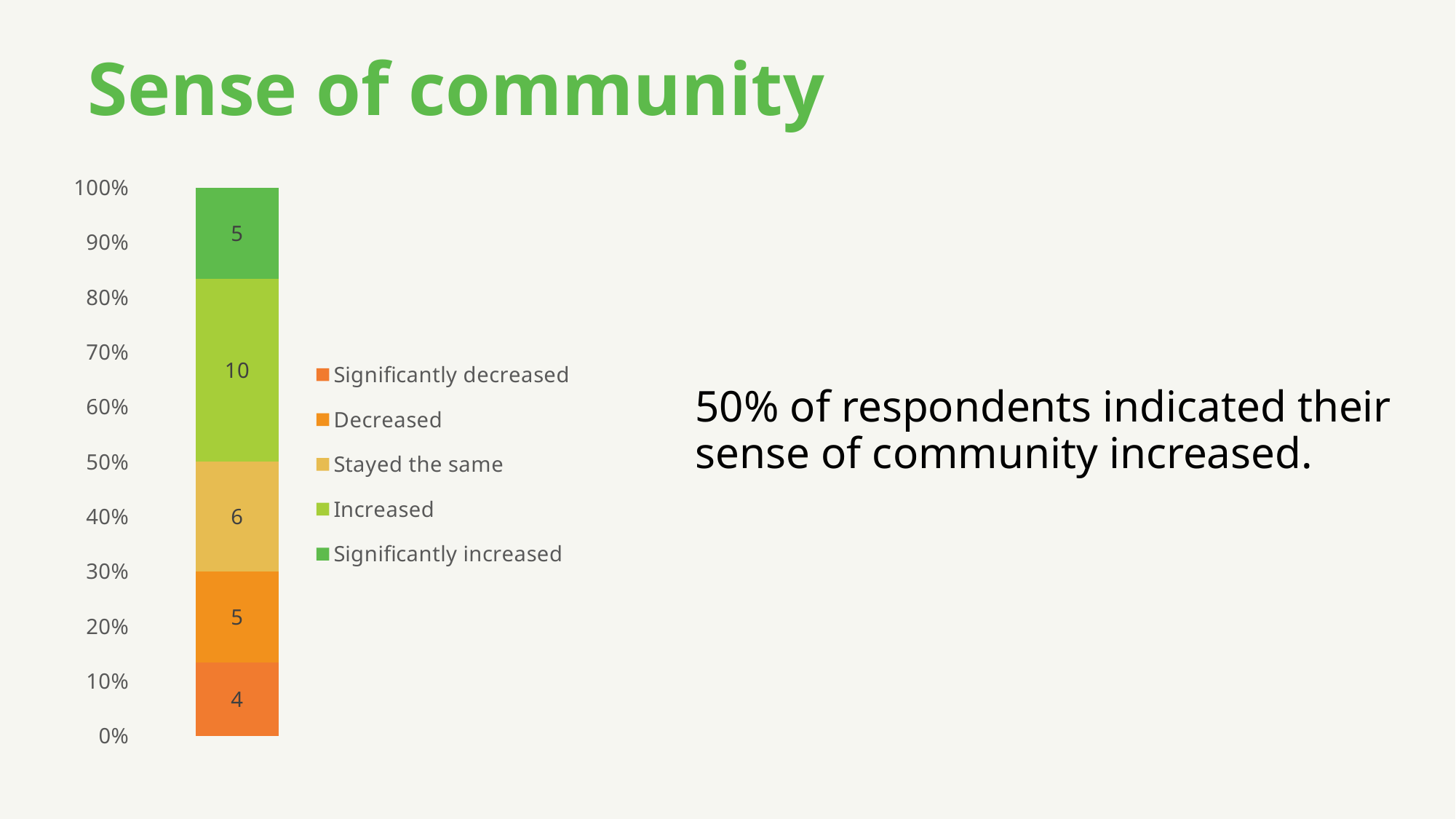
What is the total of all the segments in the stacked bar? 30 What is the difference between the Increased value and the Stayed the same value? 4 What is the data label for the Significantly decreased segment of the bar? 4 What is the data label for the Increased segment of the bar? 10 What is the data label for the Decreased segment of the bar? 5 What is the data label for the Stayed the same segment of the bar? 6 How many series does the legend list? 5 Which series has the smallest value in the bar? Significantly decreased Which series has the largest value in the bar? Increased What is the title of the slide containing the chart? Sense of community Which is larger, the Stayed the same value or the Significantly increased value? Stayed the same What kind of chart is shown on the slide? Stacked bar chart